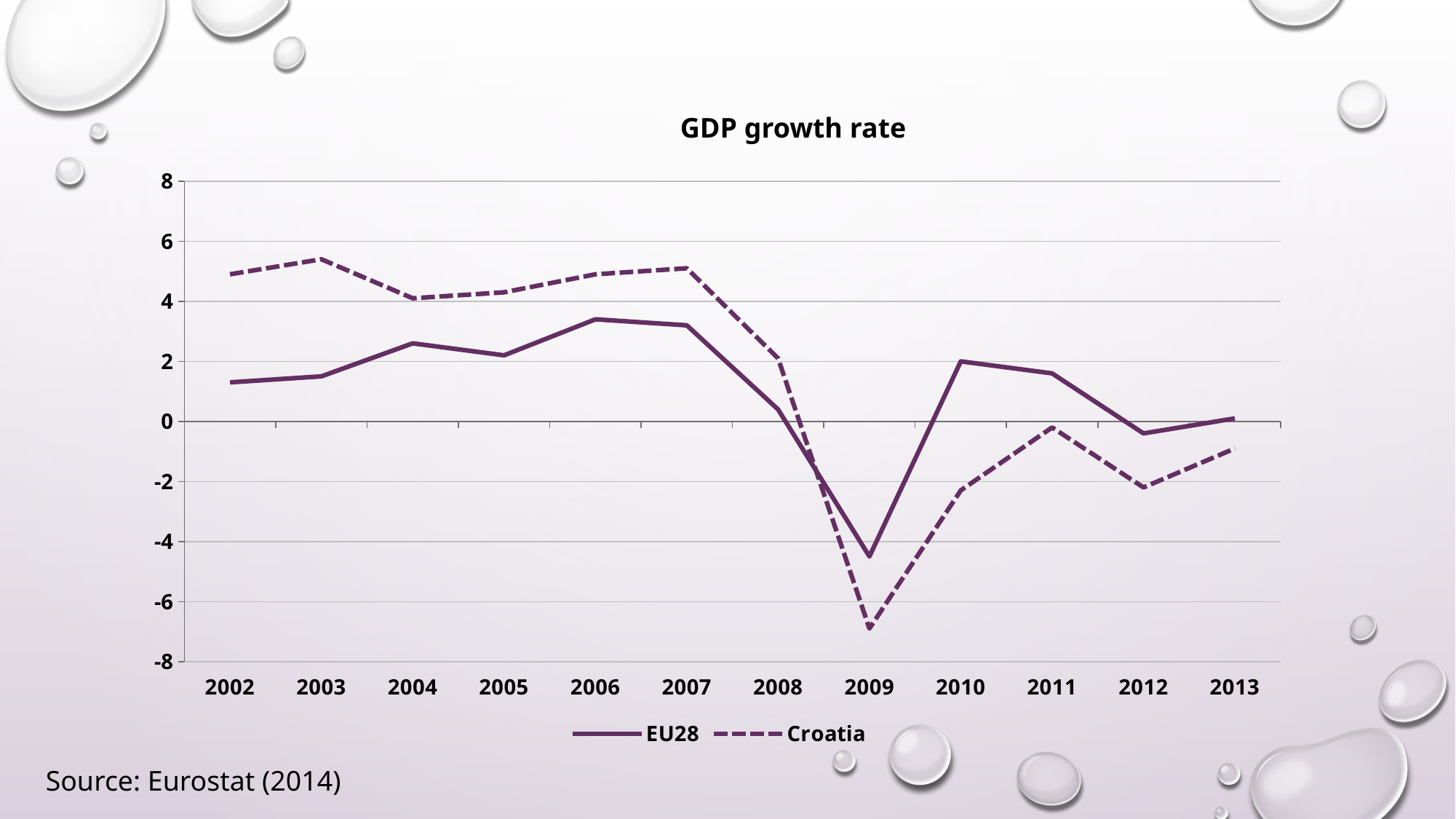
Does the EU28 series rise or fall from 2007 to 2009? fall What kind of chart is shown on the slide? line chart What is the title of the chart? GDP growth rate In 2010, which series has the higher value, EU28 or Croatia? EU28 How many years are plotted along the x axis? 12 How many series does the legend list? 2 In which year does the Croatia series reach its lowest value? 2009 Is the value for Croatia in 2003 greater or less than 4? greater Which series is drawn with a dashed line? Croatia Is the value for EU28 in 2009 greater or less than -4? less In which year does the EU28 series reach its lowest value? 2009 Is the value for Croatia in 2009 greater or less than -6? less